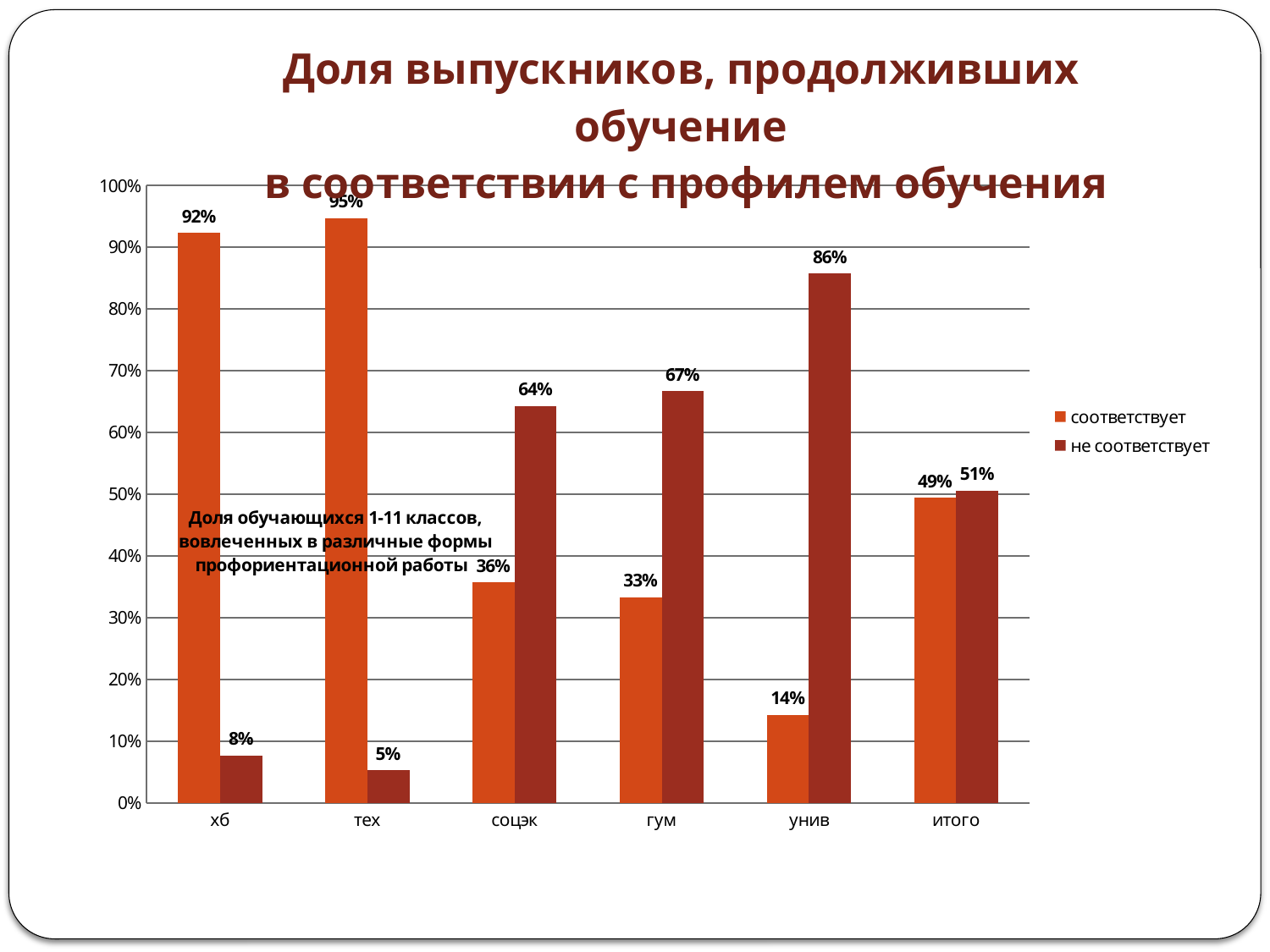
What is the value for "соответствует" in the category "итого"? 49% Which series is shown in the darker red colour? не соответствует How many categories are shown on the x axis? 6 In the category "соцэк", which series has the larger value: "соответствует" or "не соответствует"? не соответствует How many series does the legend list? 2 Which category has the lowest value for "не соответствует"? тех What kind of chart is shown on the slide? bar chart What is the difference between "не соответствует" and "соответствует" in the category "гум"? 34% What is the value for "не соответствует" in the category "унив"? 86% Which category has the highest value for "соответствует"? тех Is the value for "соответствует" in the category "унив" greater or less than 20%? less What is the value for "соответствует" in the category "хб"? 92%